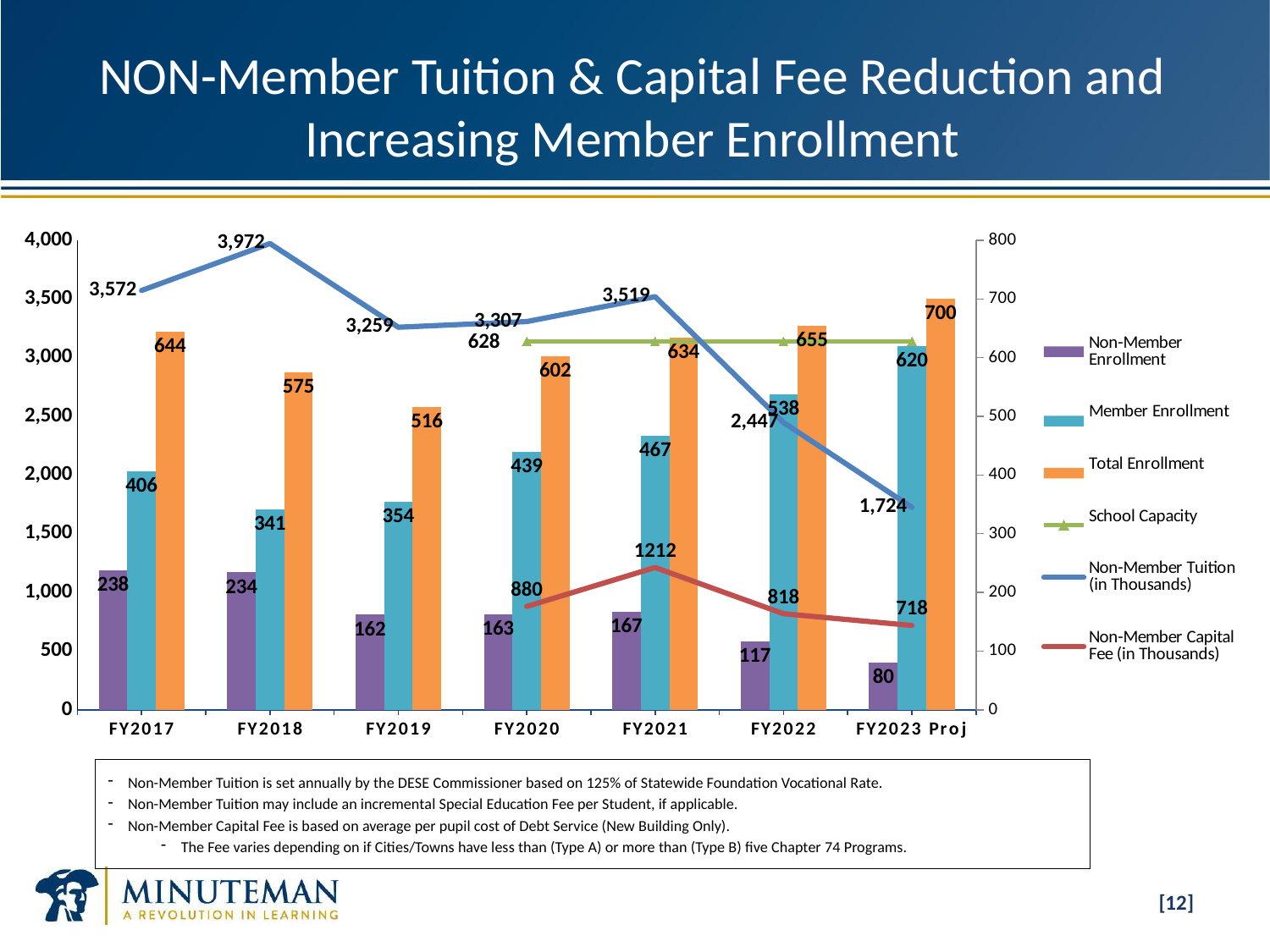
How many fiscal years are shown on the x axis? 7 What is the difference between Non-Member Tuition (in Thousands) in FY2022 and FY2023 Proj? 723 Does Non-Member Enrollment rise or fall from FY2017 to FY2023 Proj? fall What is the Non-Member Tuition (in Thousands) value for FY2018? 3,972 What is the Non-Member Capital Fee (in Thousands) value for FY2021? 1212 What is the difference between Total Enrollment in FY2023 Proj and FY2017? 56 Which is larger, Non-Member Tuition in FY2017 or in FY2021? FY2017 In which fiscal year is Member Enrollment highest? FY2023 Proj How many series does the legend list? 6 In which fiscal year is Non-Member Enrollment lowest? FY2023 Proj What is the School Capacity value shown on the chart? 628 In which fiscal year is the Non-Member Capital Fee (in Thousands) highest? FY2021